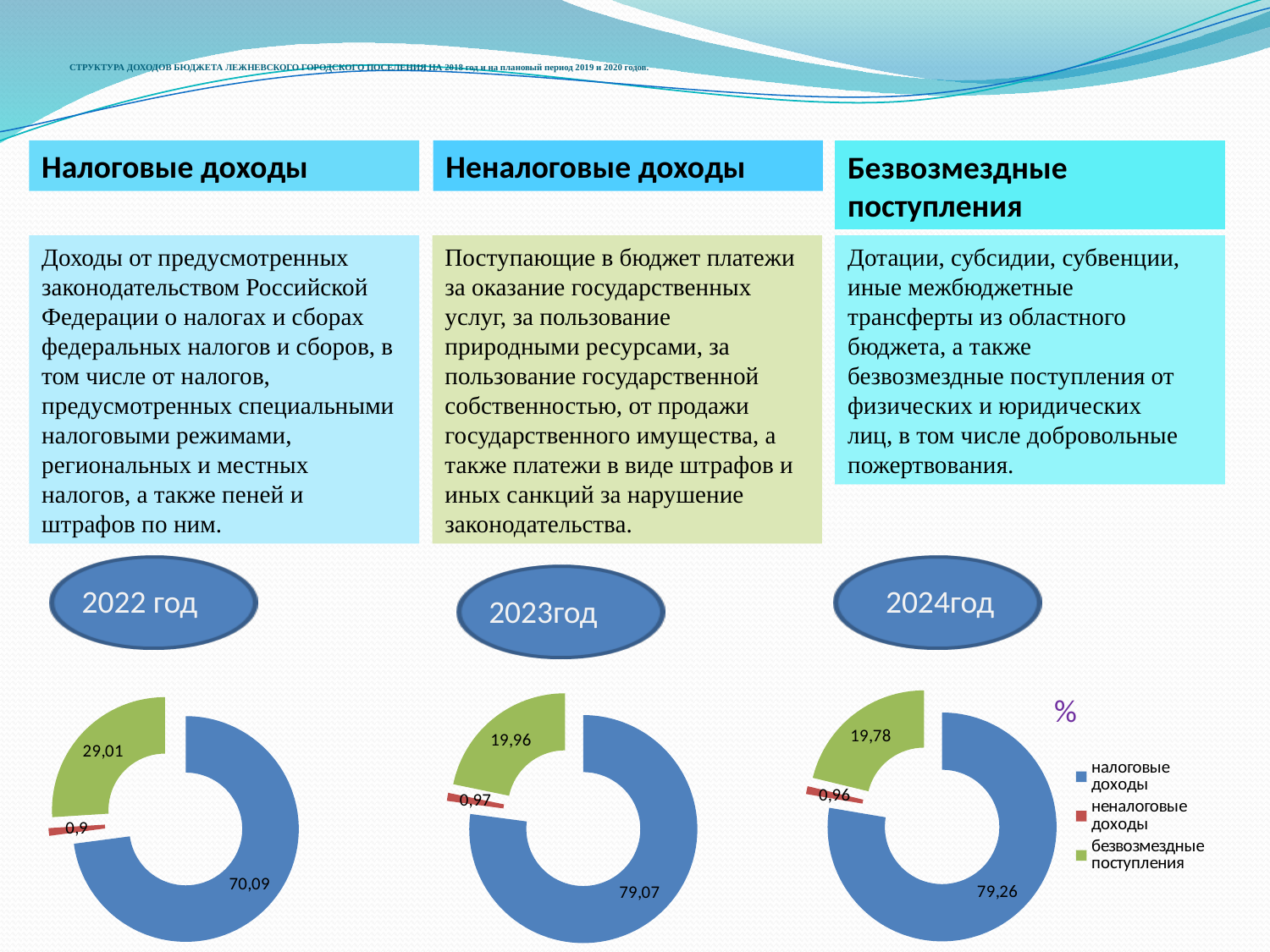
Which is larger: безвозмездные поступления in the 2022 год chart or in the 2023год chart? 2022 год In the 2022 год chart, what is the value for безвозмездные поступления? 29,01 Which colour represents неналоговые доходы in the charts? red In the 2024год chart, which category has the largest share? налоговые доходы In the 2023год chart, which category has the smallest share? неналоговые доходы In the 2022 год chart, what is the value for налоговые доходы? 70,09 How many entries does the legend list? 3 In the 2022 год chart, what is the difference between налоговые доходы and безвозмездные поступления? 41,08 How many categories does each doughnut chart show? 3 In the 2024год chart, what is the value for безвозмездные поступления? 19,78 In the 2023год chart, what is the value for неналоговые доходы? 0,97 What kind of chart is used for the 2023год data? doughnut chart